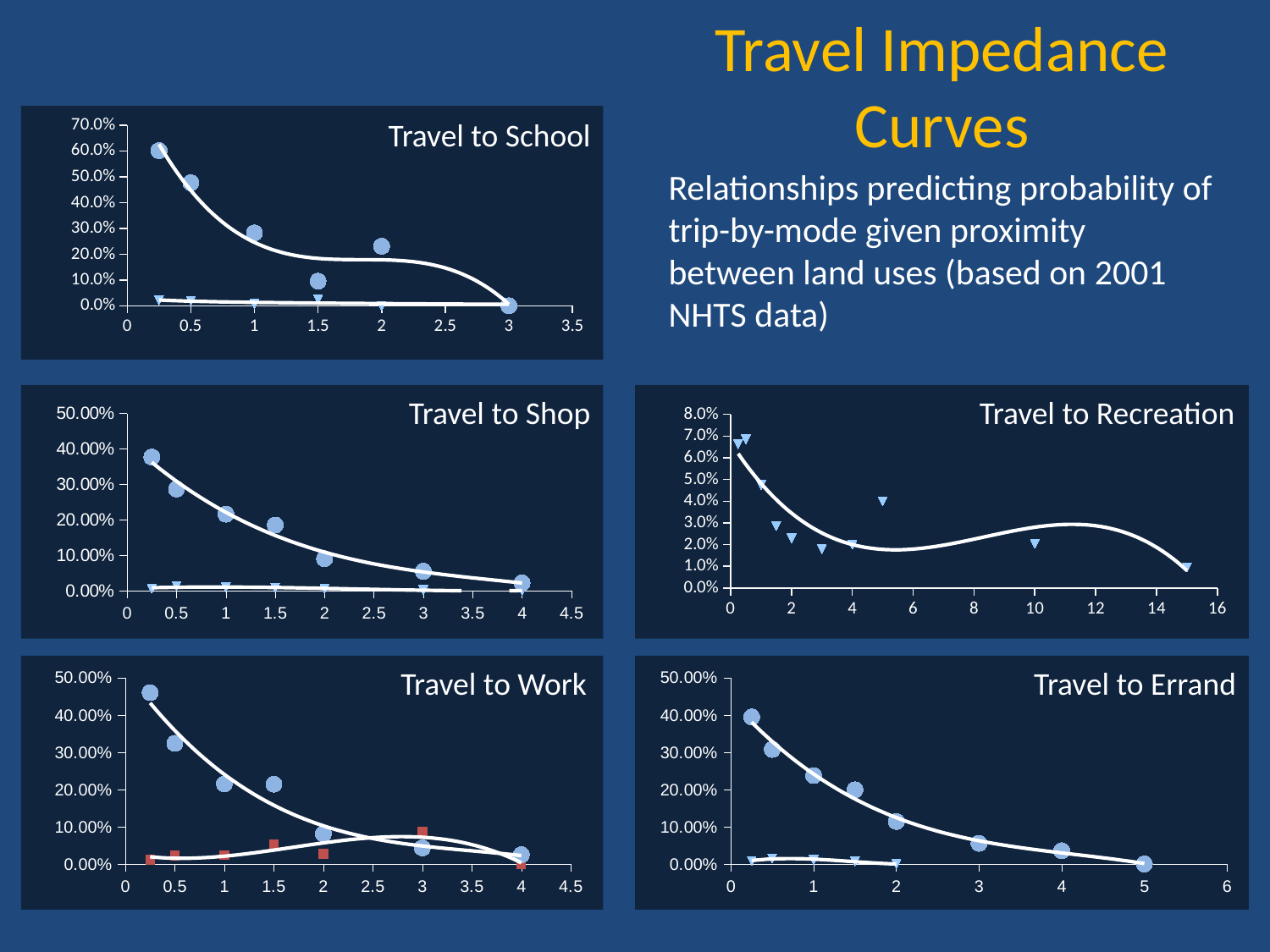
In the Travel to Work chart, is the value of the large circle point at x = 0.25 greater or less than 40.00%? greater In the Travel to School chart, is the value of the large circle point at x = 0.25 greater or less than 50.0%? greater In the Travel to Work chart, do the large circle values rise or fall as x increases? fall In the Travel to Errand chart, do the large circle values rise or fall as x increases? fall How many large circle points are plotted in the Travel to School chart? 6 How many charts are shown on the slide? 5 What is the highest value shown on the y axis of the Travel to Recreation chart? 8.0% In the Travel to Recreation chart, is the value of the point at x = 15 greater or less than 2.0%? less What kind of chart is the Travel to School chart? scatter chart